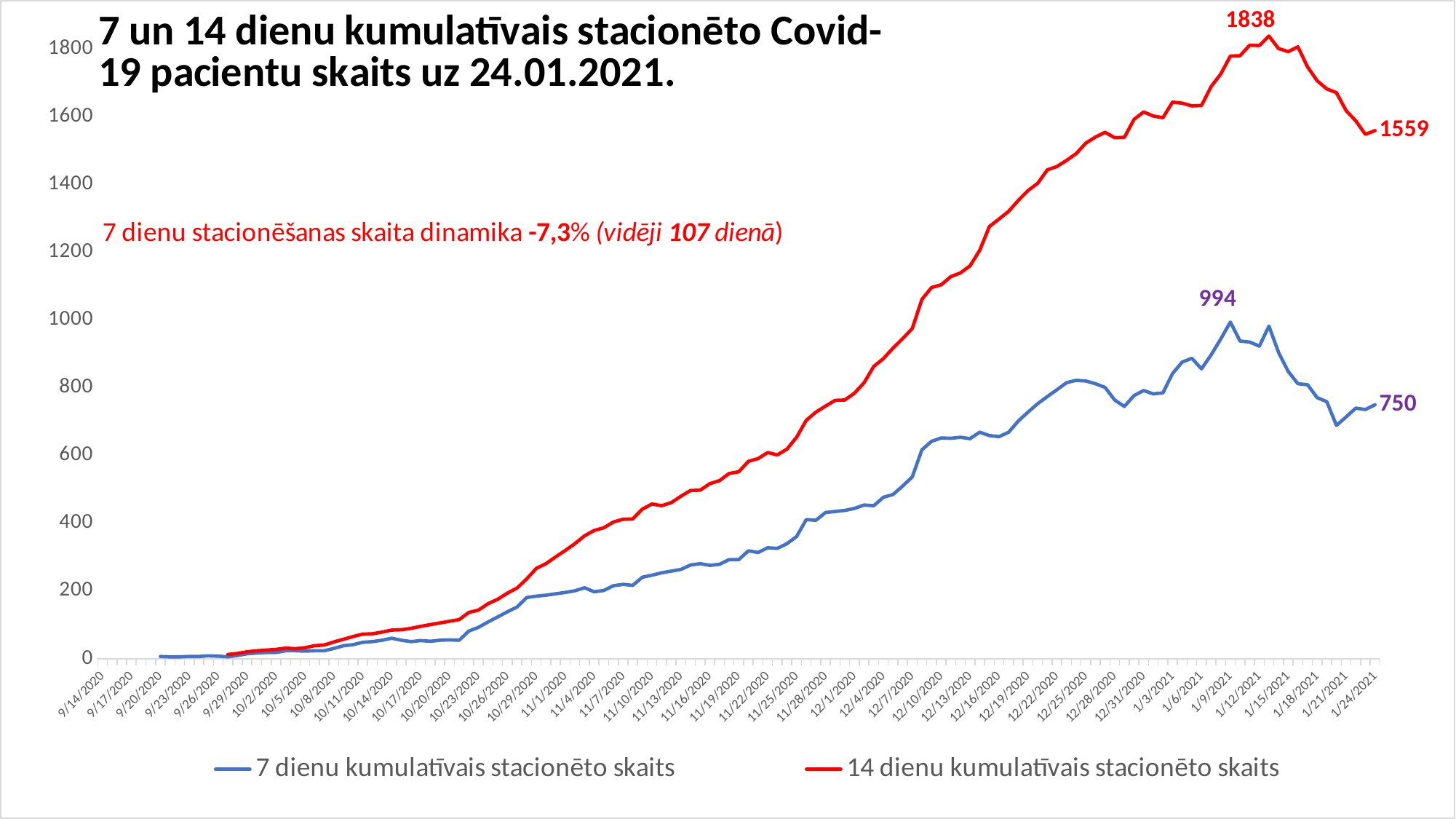
Is the value of the 14 dienu series on 12/10/2020 greater or less than 1000? greater What is the final labelled value of the 14 dienu kumulatīvais stacionēto skaits series? 1559 How many series does the legend list? 2 What is the labelled peak value of the 7 dienu kumulatīvais stacionēto skaits series? 994 What is the difference between the labelled peak (994) and the final labelled value (750) of the 7 dienu series? 244 Is the value of the 7 dienu series on 11/25/2020 greater or less than 400? less What is the difference between the final labelled values of the 14 dienu series (1559) and the 7 dienu series (750)? 809 By how much did the 14 dienu series fall from its labelled peak of 1838 to its final labelled value of 1559? 279 What kind of chart is shown on the slide? Line chart At the end of the chart, which series has the higher value: 7 dienu or 14 dienu kumulatīvais stacionēto skaits? 14 dienu kumulatīvais stacionēto skaits What is the labelled peak value of the 14 dienu kumulatīvais stacionēto skaits series? 1838 What is the final labelled value of the 7 dienu kumulatīvais stacionēto skaits series? 750